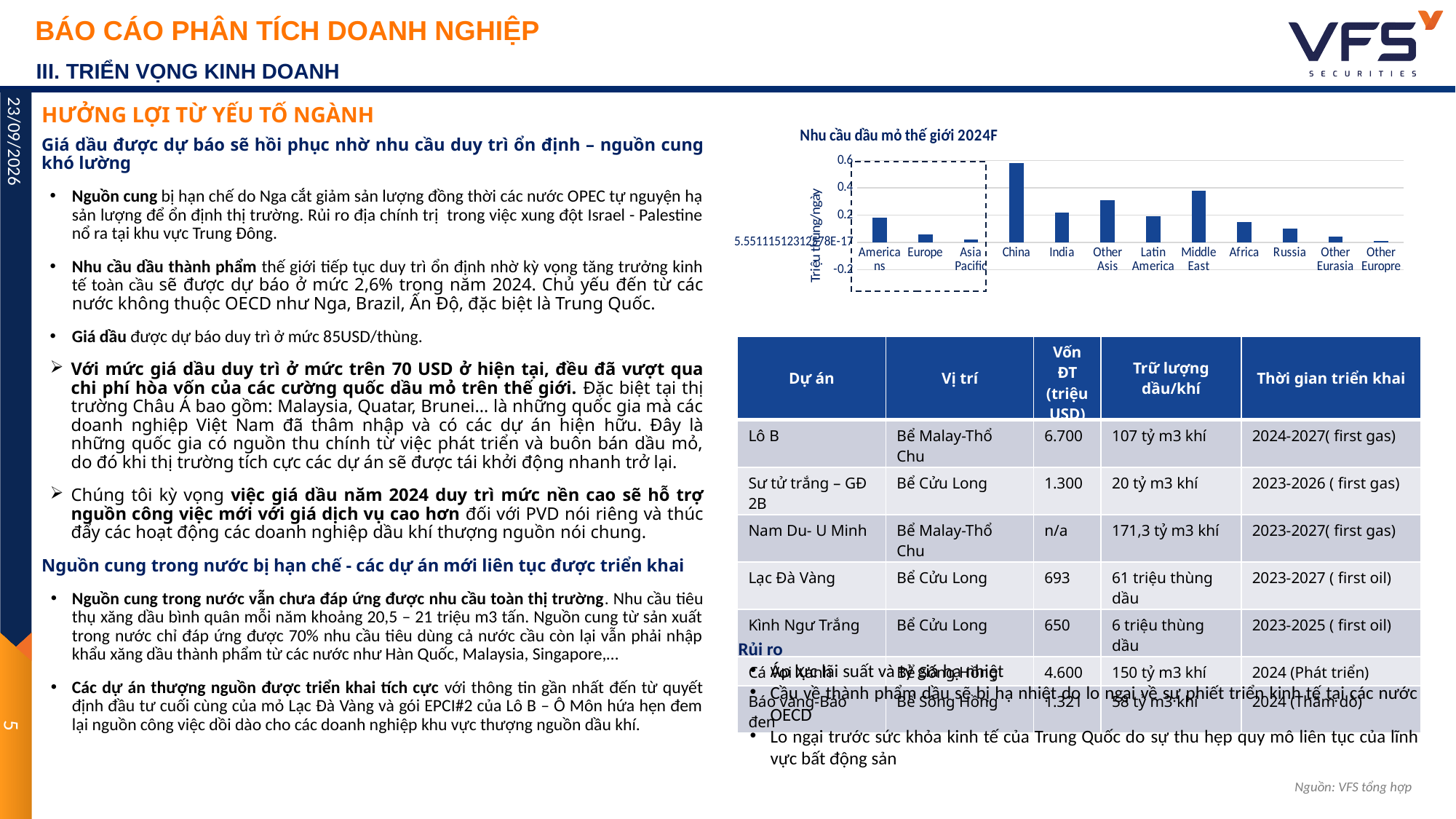
In the 'Nhu cầu dầu mỏ thế giới 2024F' chart, which is larger: China or Middle East? China In the 'Nhu cầu dầu mỏ thế giới 2024F' chart, is the value for China greater or less than 0.4? greater In the 'Nhu cầu dầu mỏ thế giới 2024F' chart, is the value for Other Asis greater or less than 0.2? greater In the 'Nhu cầu dầu mỏ thế giới 2024F' chart, is the value for Russia greater or less than 0.2? less How many categories are plotted in the 'Nhu cầu dầu mỏ thế giới 2024F' chart? 12 In the 'Nhu cầu dầu mỏ thế giới 2024F' chart, which is larger: Americans or Europe? Americans In the 'Nhu cầu dầu mỏ thế giới 2024F' chart, which is larger: Middle East or Africa? Middle East What is the label on the vertical axis of the 'Nhu cầu dầu mỏ thế giới 2024F' chart? Triệu thùng/ngày What kind of chart is shown under the title 'Nhu cầu dầu mỏ thế giới 2024F'? Bar chart Which category has the highest value in the 'Nhu cầu dầu mỏ thế giới 2024F' chart? China